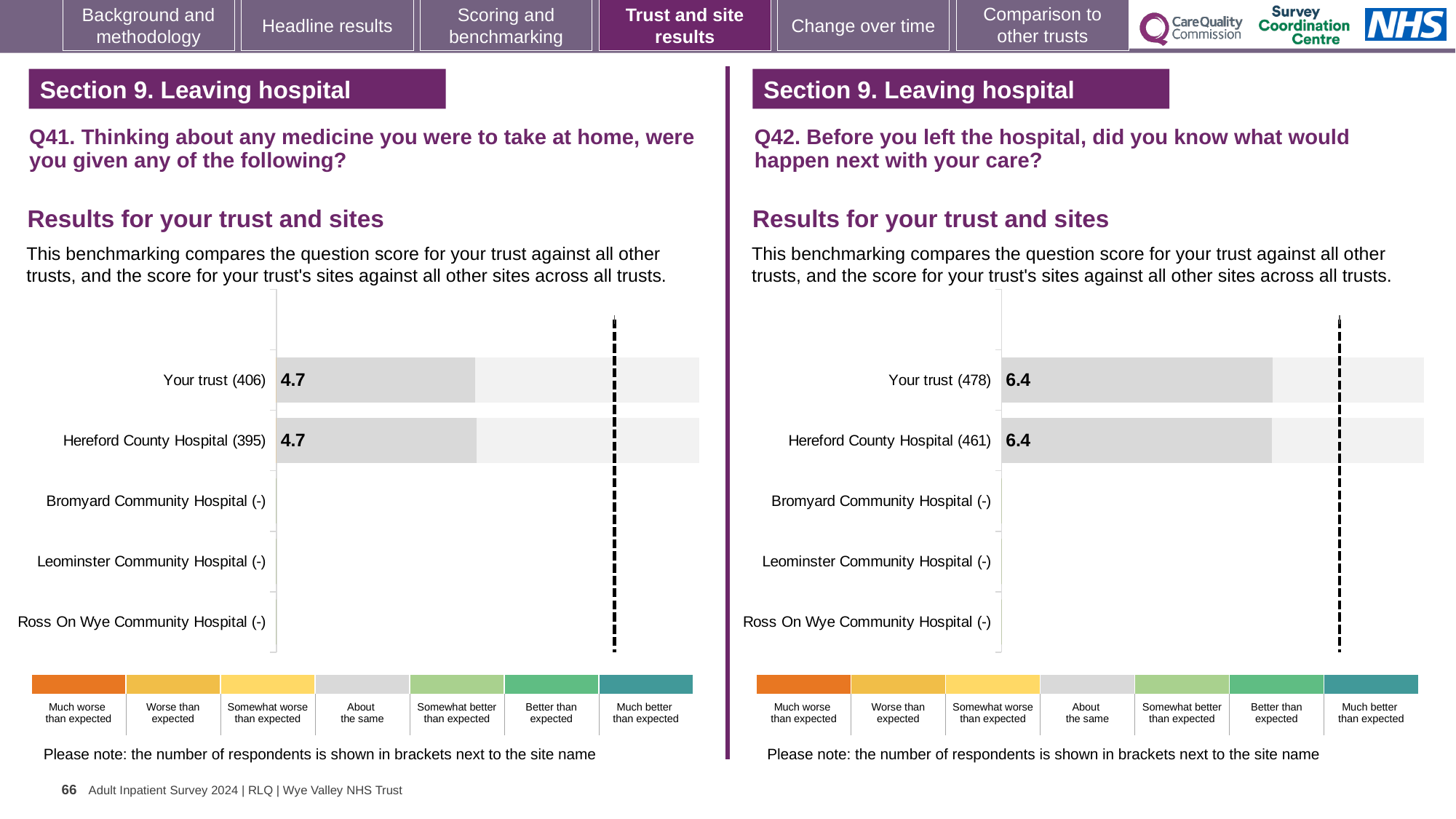
How many site or trust categories are listed on the y axis of the Q41 chart on the left? 5 In the Q42 chart on the right, how many respondents are shown in brackets for Hereford County Hospital? 461 What kind of chart is used for the Q42 results on the right? Bar chart In the Q42 chart on the right, what is the score for Your trust? 6.4 In the Q41 chart on the left, how many respondents are shown in brackets for Your trust? 406 In the Q42 chart on the right, what is the score for Hereford County Hospital? 6.4 In the Q41 chart on the left, what is the score for Your trust? 4.7 In the Q41 chart on the left, what is the difference between the score for Your trust and the score for Hereford County Hospital? 0 How many site or trust categories are listed on the y axis of the Q42 chart on the right? 5 In the Q41 chart on the left, what is the score for Hereford County Hospital? 4.7 In the Q42 chart on the right, what is the difference between the score for Your trust and the score for Hereford County Hospital? 0 How many benchmark categories does the colour legend below the Q41 chart on the left list? 7